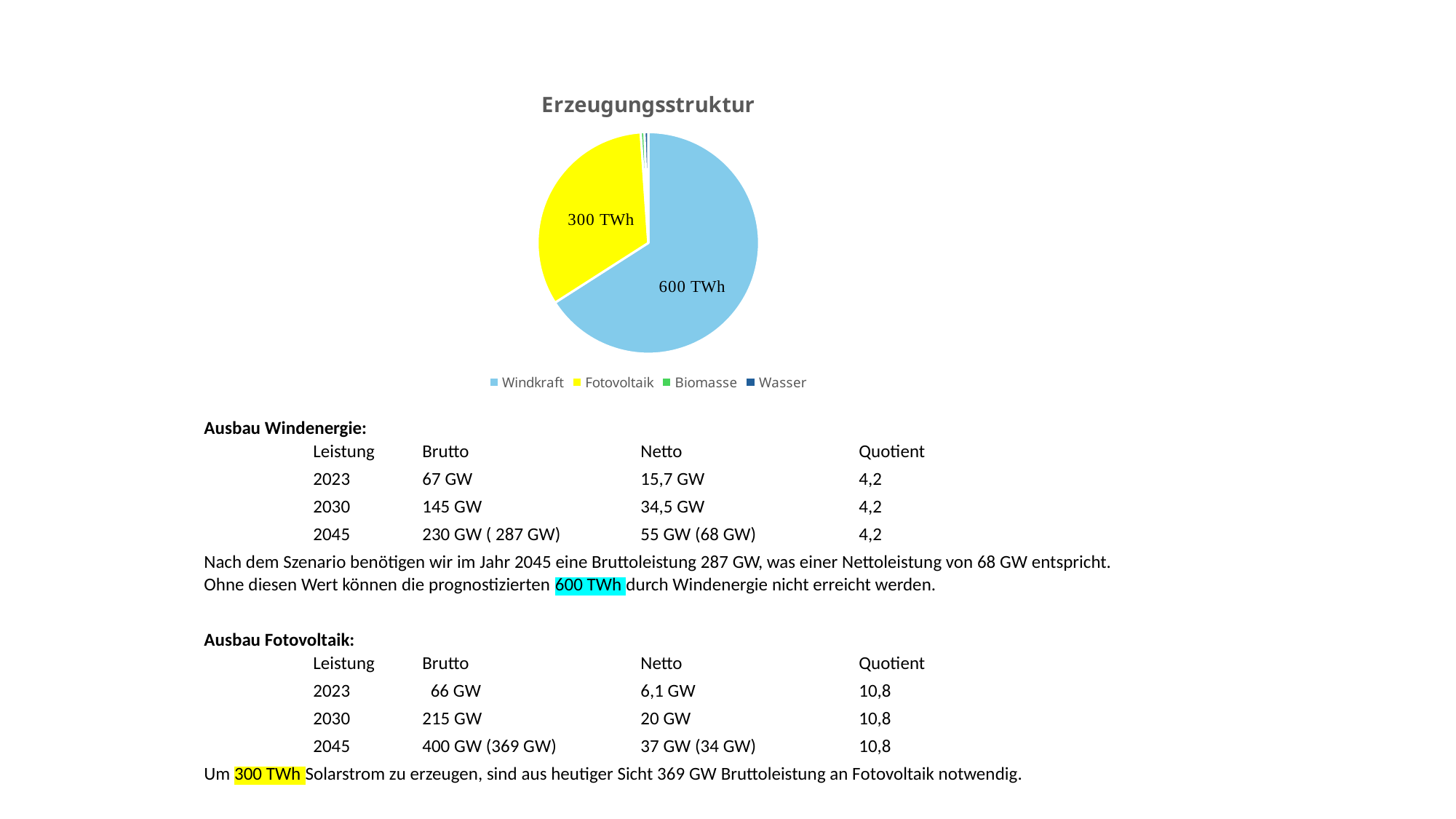
What is the title of the chart on the slide? Erzeugungsstruktur What value is shown for Fotovoltaik in the Erzeugungsstruktur pie chart? 300 TWh Which is larger in the pie chart, Windkraft or Fotovoltaik? Windkraft What value is shown for Windkraft in the Erzeugungsstruktur pie chart? 600 TWh What colour is the Fotovoltaik slice in the pie chart? Yellow Is the value for Windkraft in the pie chart greater or less than the value for Fotovoltaik? greater What is the difference between the Windkraft and Fotovoltaik values in the pie chart? 300 TWh How many categories does the legend of the Erzeugungsstruktur chart list? 4 What kind of chart is shown on the slide? Pie chart Which category has the largest slice in the Erzeugungsstruktur pie chart? Windkraft